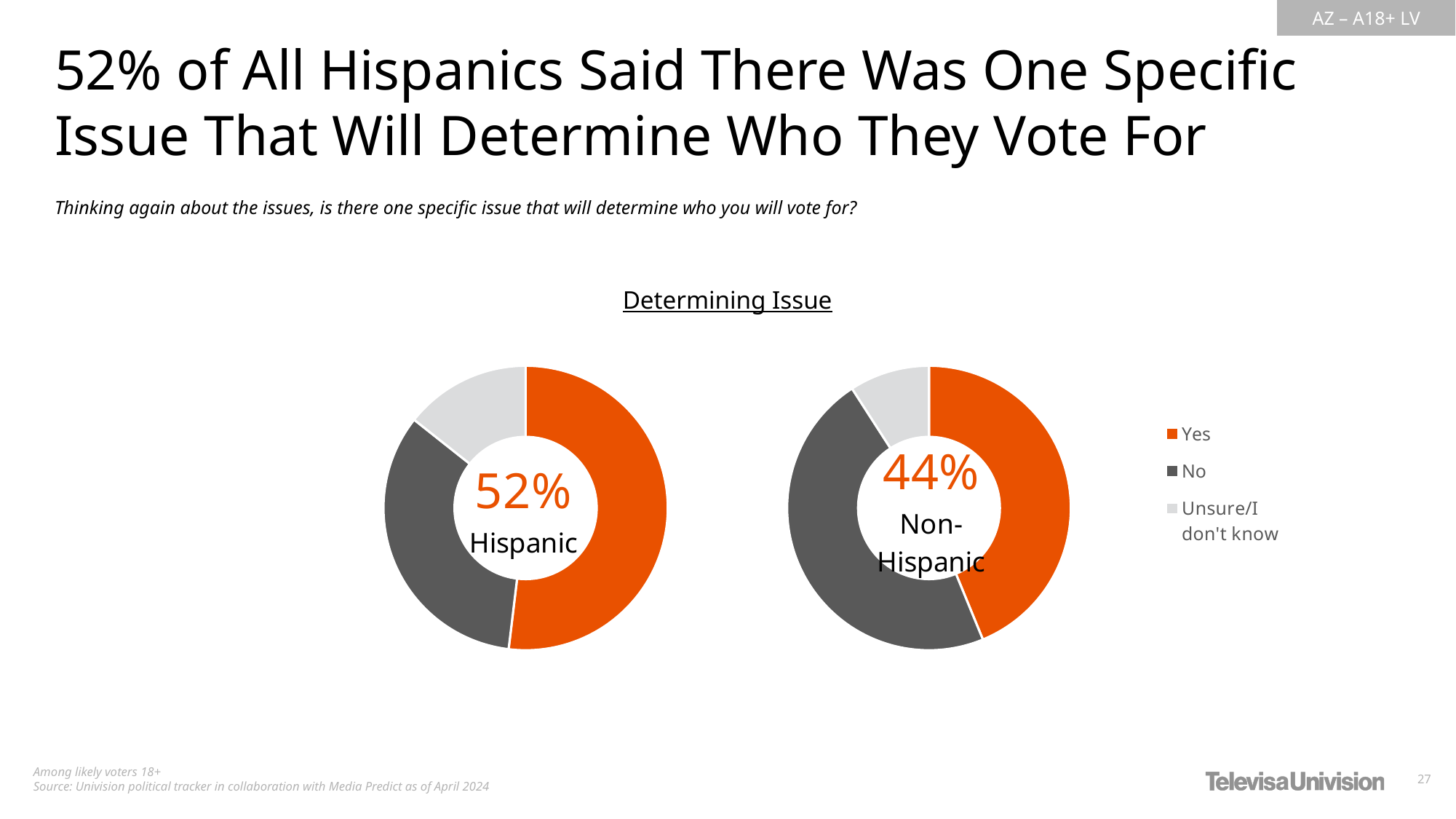
In the Non-Hispanic donut chart, what percentage said Yes? 44% In the Hispanic donut chart, is the Unsure/I don't know slice greater or less than 25%? less How many categories does the legend list for the Determining Issue charts? 3 How many donut charts are shown on the slide? 2 In the Hispanic donut chart, what percentage said Yes, there is one specific issue that will determine who they vote for? 52% What kind of chart is used to show the Determining Issue data? Donut (pie) chart In the Hispanic donut chart, which response is the largest slice? Yes Which group has the larger Yes share, Hispanic or Non-Hispanic? Hispanic In the Non-Hispanic donut chart, is the No slice greater or less than 25%? greater What is the difference in percentage points between the Hispanic Yes share and the Non-Hispanic Yes share? 8 percentage points In the Non-Hispanic donut chart, which response is the smallest slice? Unsure/I don't know What is the title shown above the two donut charts? Determining Issue